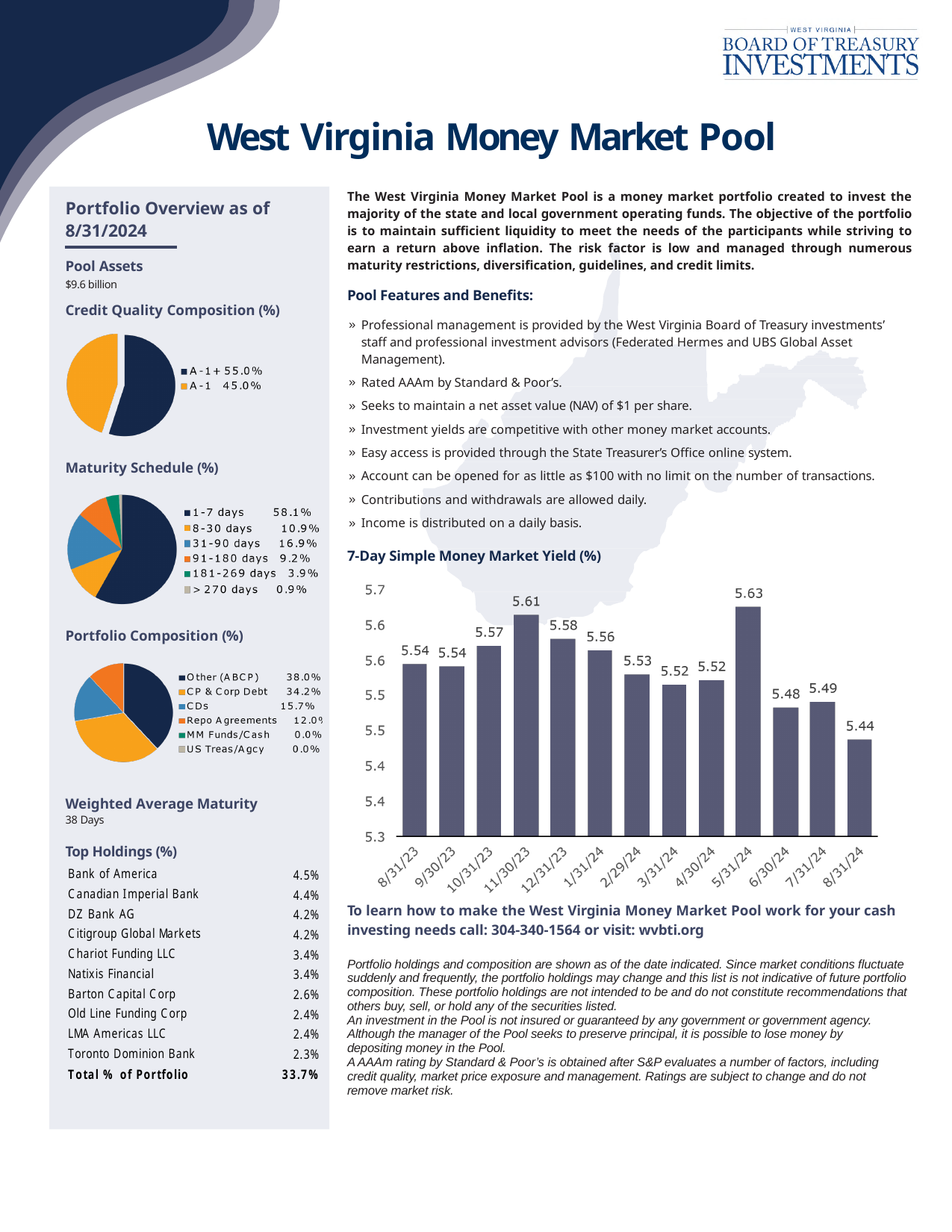
In the 7-Day Simple Money Market Yield (%) chart, what is the difference between the values for 11/30/23 and 8/31/24? 0.17 In the Portfolio Composition (%) pie chart, which is larger, Other (ABCP) or CP & Corp Debt? Other (ABCP) In the Maturity Schedule (%) pie chart, what is the value for 31-90 days? 16.9% In the Maturity Schedule (%) pie chart, which category has the largest share? 1-7 days What kind of chart is the 7-Day Simple Money Market Yield (%) chart? bar chart In the 7-Day Simple Money Market Yield (%) chart, what is the value for 5/31/24? 5.63 How many categories does the legend of the Maturity Schedule (%) pie chart list? 6 In the 7-Day Simple Money Market Yield (%) chart, which date has the lowest yield? 8/31/24 In the 7-Day Simple Money Market Yield (%) chart, is the value for 6/30/24 greater or less than 5.5? less In the Credit Quality Composition (%) pie chart, what share is A-1+? 55.0% In the 7-Day Simple Money Market Yield (%) chart, which date has the highest yield? 5/31/24 In the 7-Day Simple Money Market Yield (%) chart, how many dates are plotted? 13